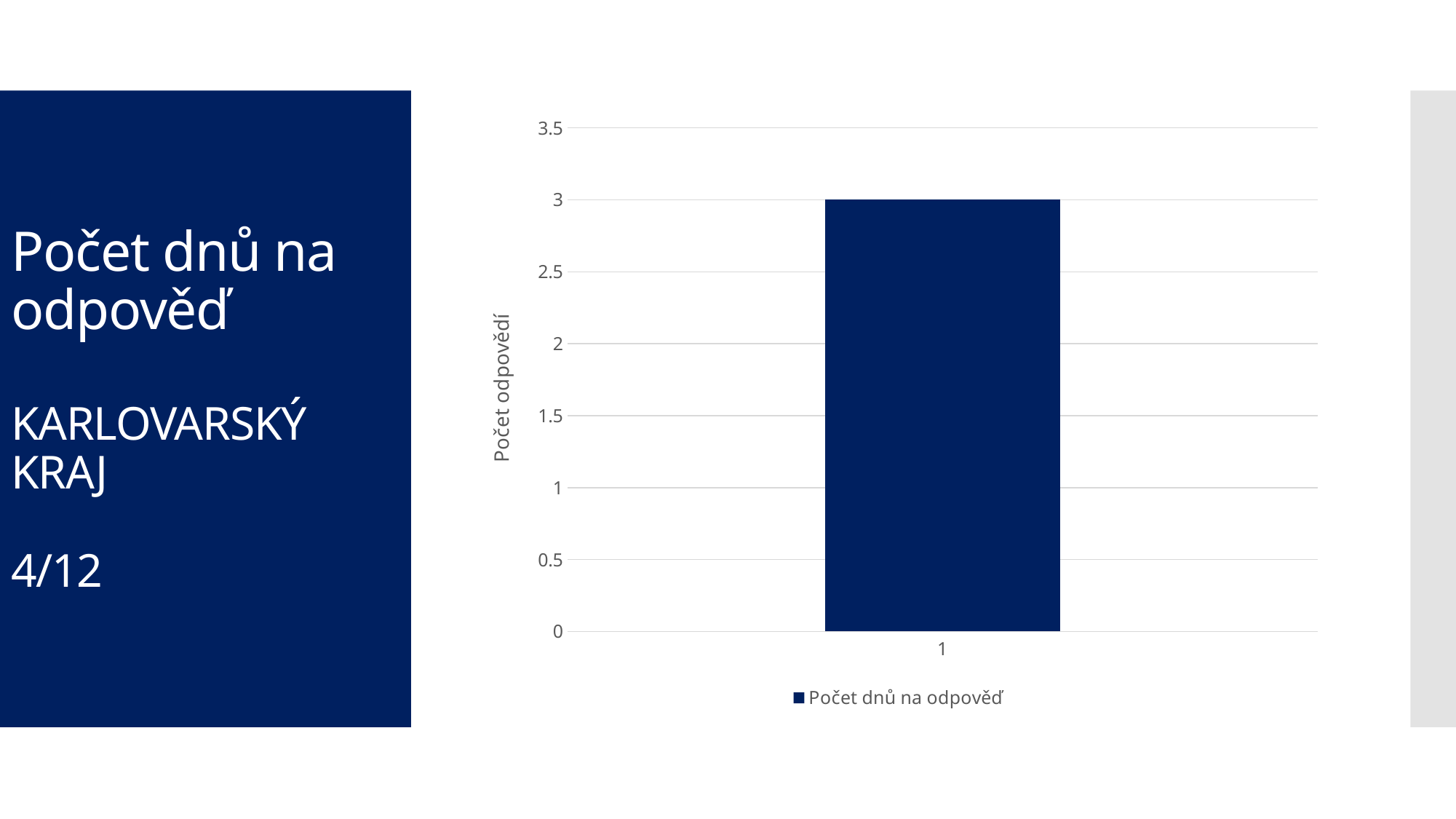
What is the value of the bar for category 1? 3 What is the name of the series shown in the legend? Počet dnů na odpověď Is the value for category 1 greater or less than 2.5? greater Is the value for category 1 greater or less than 3.5? less How many series does the legend list? 1 What kind of chart is shown on the slide? bar chart How many bars are plotted in the chart? 1 What is the label on the vertical axis of the chart? Počet odpovědí